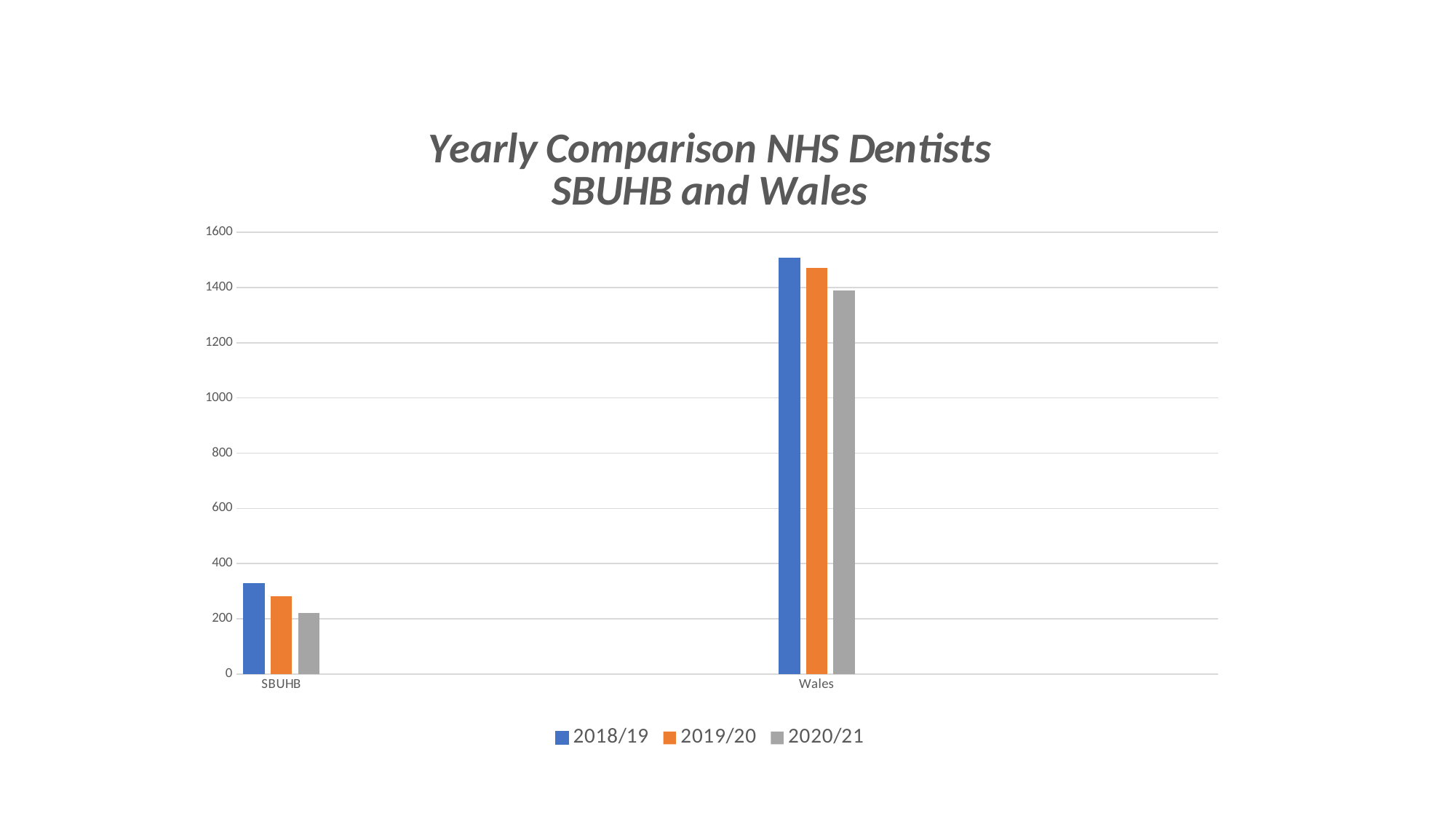
For SBUHB, do the values rise or fall from 2018/19 to 2020/21? fall Is the value for Wales in 2018/19 greater or less than 1400? greater Which category has the lowest values, SBUHB or Wales? SBUHB For Wales, which is larger, the 2018/19 value or the 2020/21 value? 2018/19 What is the title of the chart? Yearly Comparison NHS Dentists SBUHB and Wales How many categories are shown on the x axis? 2 What kind of chart is shown on the slide? bar chart Is the value for SBUHB in 2018/19 greater or less than 400? less How many series does the legend list? 3 Which category has the highest values, SBUHB or Wales? Wales Is the value for Wales in 2020/21 greater or less than 1200? greater